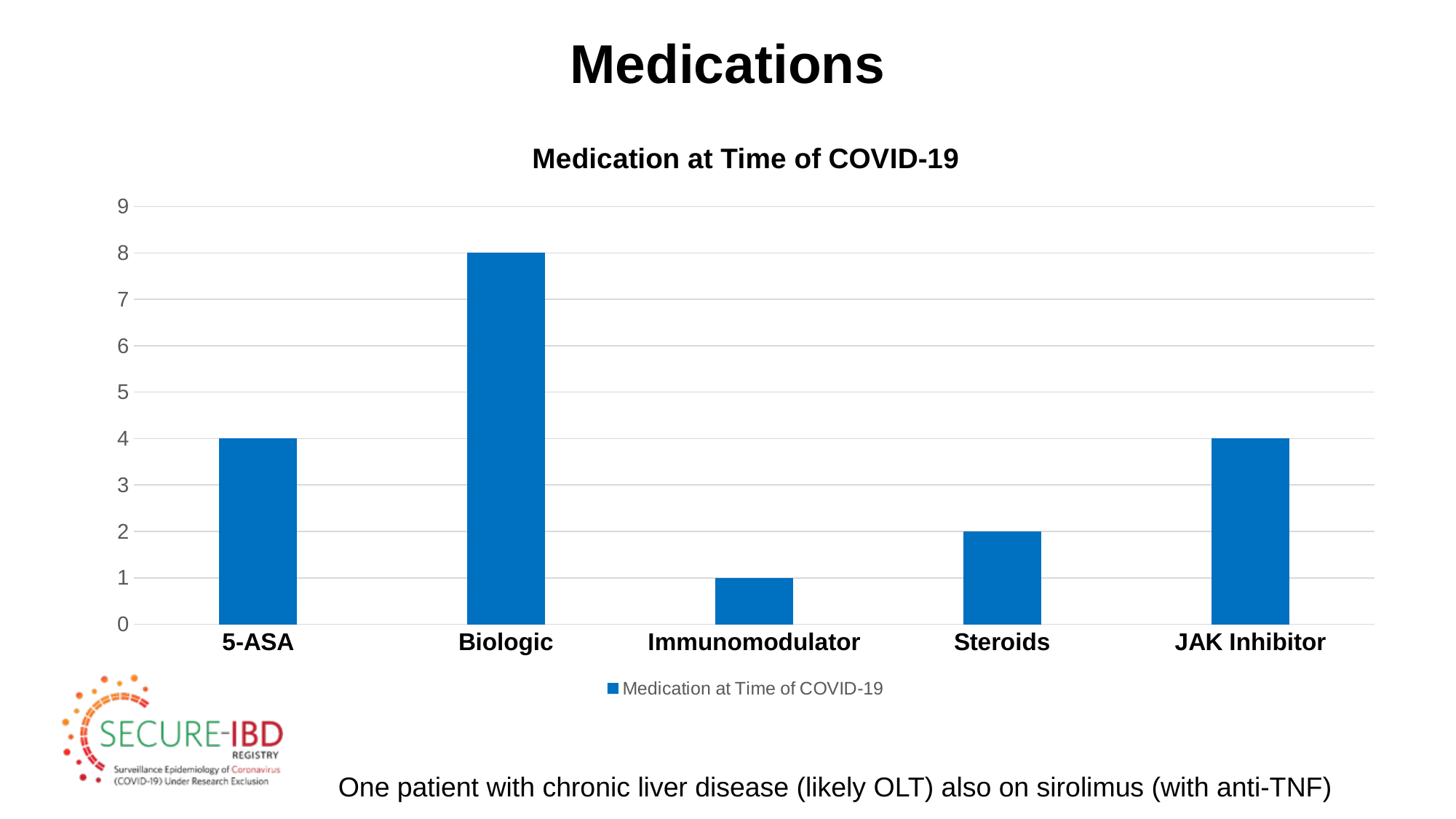
What is the difference between the values for Biologic and 5-ASA? 4 What kind of chart is shown on the slide? Bar chart Which medication category has the lowest value? Immunomodulator Which medication category has the highest value? Biologic What is the value for Immunomodulator in the chart? 1 What is the value for JAK Inhibitor in the chart? 4 How many series does the legend list? 1 How many medication categories are shown on the x axis? 5 What is the value for Steroids in the chart? 2 What is the value for Biologic in the chart? 8 Which is larger, the value for Steroids or the value for Immunomodulator? Steroids What is the title of the chart? Medication at Time of COVID-19